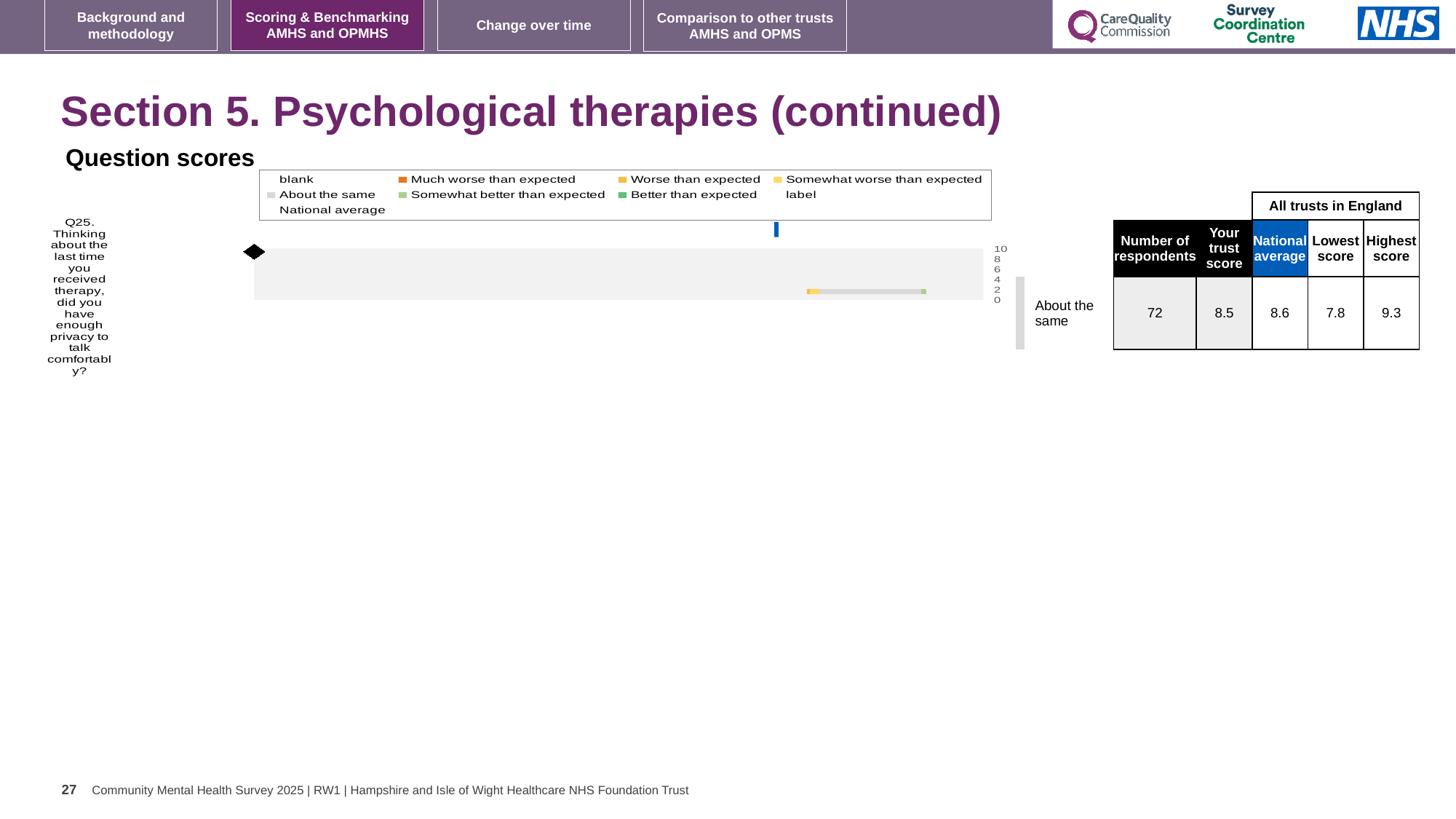
What is the highest tick value shown on the chart's axis? 10 In the table beside the chart, which is larger for Q25: the trust score or the national average? national average In the table beside the chart, what is the national average for Q25? 8.6 In the table beside the chart, what is the number of respondents for Q25? 72 What kind of chart is shown under 'Question scores'? bar chart In the table beside the chart, what is 'Your trust score' for Q25? 8.5 In the table beside the chart, what is the highest score among all trusts in England for Q25? 9.3 In the table beside the chart, what is the lowest score among all trusts in England for Q25? 7.8 How many questions (categories) are plotted in the chart? 1 What benchmark category label is shown beside the chart for Q25? About the same Which question number is plotted in the chart? Q25 How many entries does the chart's legend list? 9